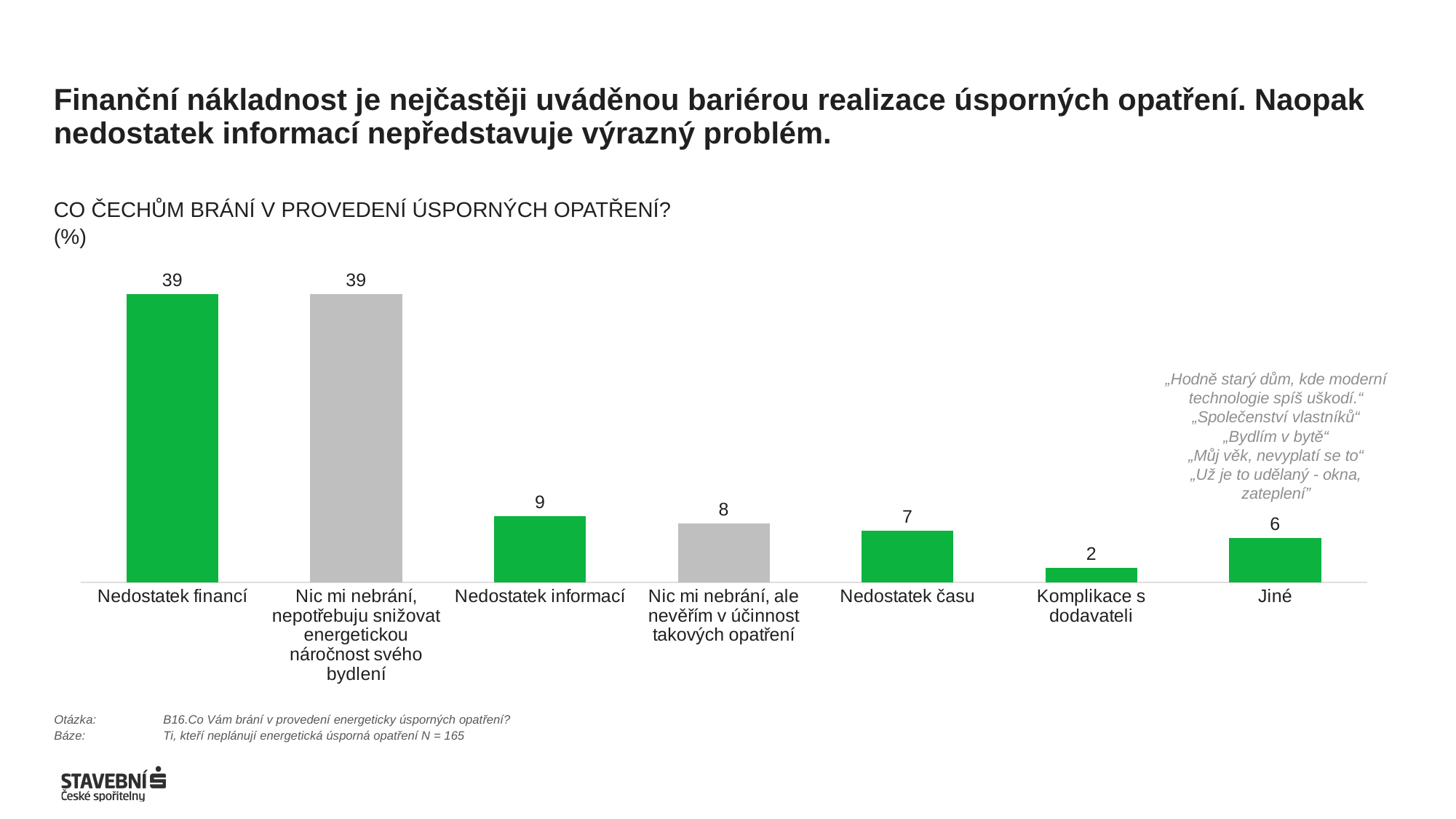
What is the value for "Nedostatek financí"? 39 How many categories are shown in the chart? 7 What is the value for "Komplikace s dodavateli"? 2 Which is larger: the value for "Nedostatek informací" or the value for "Jiné"? Nedostatek informací What is the difference between the values for "Nedostatek financí" and "Nedostatek informací"? 30 What is the value for "Jiné"? 6 What unit is indicated under the chart title? (%) What is the value for "Nedostatek informací"? 9 What is the difference between the values for "Nedostatek času" and "Komplikace s dodavateli"? 5 What is the value for "Nedostatek času"? 7 Which category has the lowest value? Komplikace s dodavateli What kind of chart is shown on the slide? Bar chart